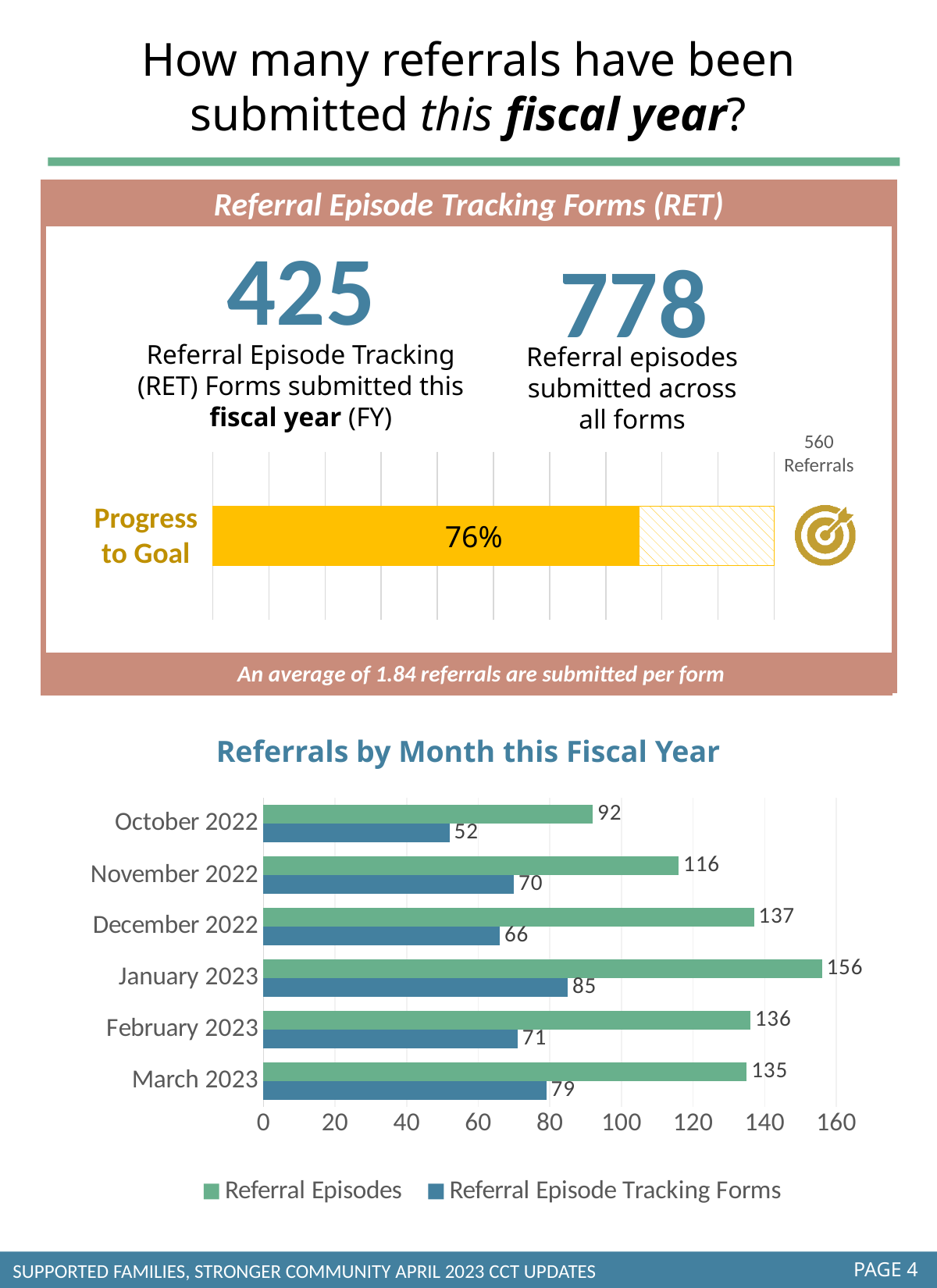
In the 'Referrals by Month this Fiscal Year' chart, how many Referral Episodes were there in January 2023? 156 What kind of chart is 'Referrals by Month this Fiscal Year'? Bar chart In the 'Referrals by Month this Fiscal Year' chart, which month has the highest number of Referral Episodes? January 2023 In the 'Referrals by Month this Fiscal Year' chart, what is the difference between Referral Episodes and Referral Episode Tracking Forms in January 2023? 71 In the 'Progress to Goal' bar, what is the goal shown at the end of the bar? 560 Referrals In the 'Referrals by Month this Fiscal Year' chart, how many series does the legend list? 2 In the 'Progress to Goal' bar, what percentage of the goal has been reached? 76% In the 'Referrals by Month this Fiscal Year' chart, how many months are shown? 6 In the 'Referrals by Month this Fiscal Year' chart, which series is shown in green? Referral Episodes In the 'Referrals by Month this Fiscal Year' chart, how many Referral Episode Tracking Forms were submitted in October 2022? 52 In the 'Referrals by Month this Fiscal Year' chart, which is larger: Referral Episodes in December 2022 or in November 2022? December 2022 In the 'Referrals by Month this Fiscal Year' chart, which month has the lowest number of Referral Episode Tracking Forms? October 2022